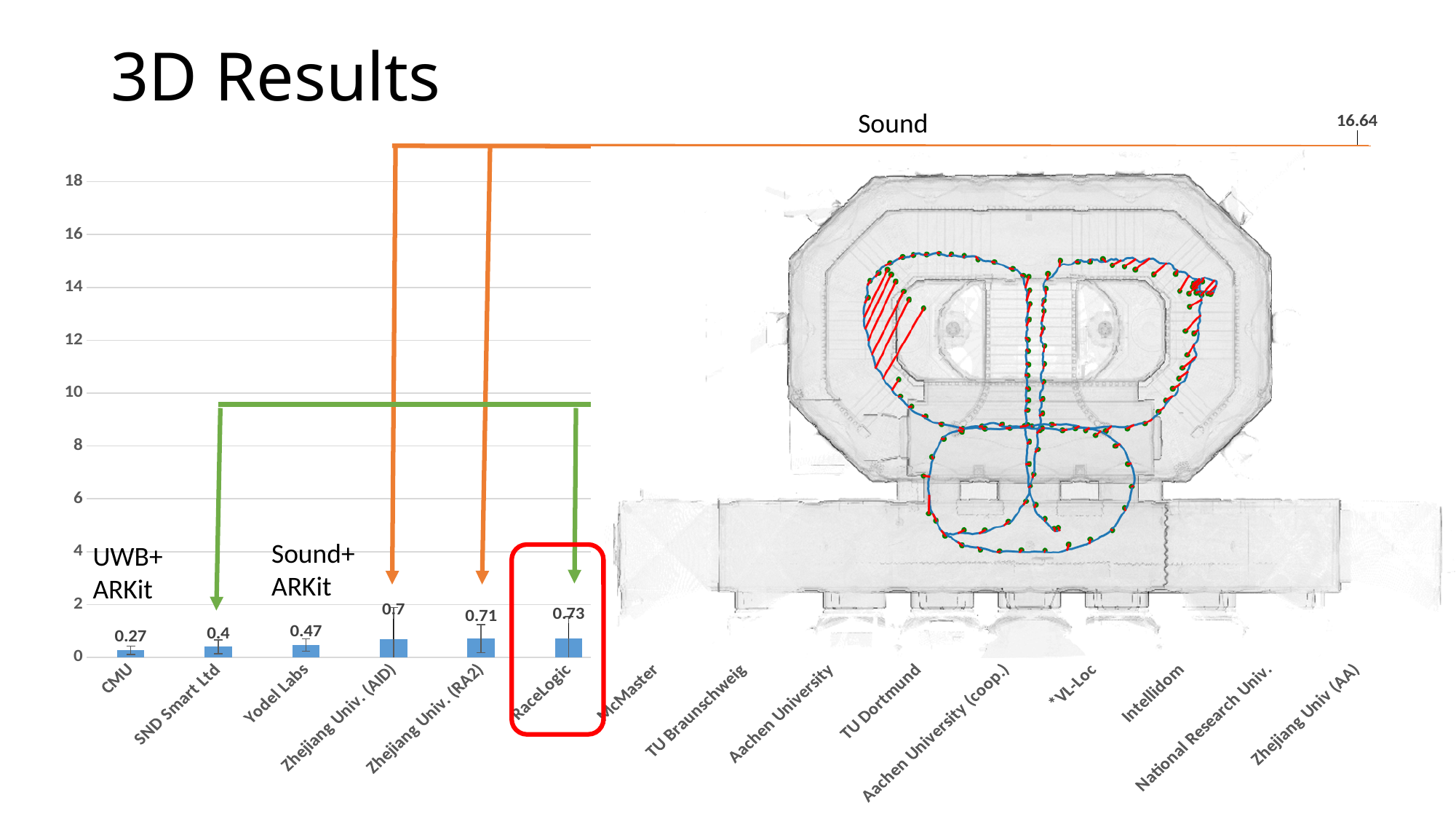
Which category on the chart is highlighted with a red box? RaceLogic What is the value for RaceLogic? 0.73 Among the six bars with printed data labels, which category has the highest value? RaceLogic What is the value for Zhejiang Univ. (AID)? 0.7 Is the value for Zhejiang Univ. (RA2) greater or less than 2? less What is the value for Yodel Labs? 0.47 What is the value for CMU? 0.27 Which is larger, the value for SND Smart Ltd or the value for Yodel Labs? Yodel Labs How many categories are labelled on the x axis of the chart? 15 What is the difference between the values for RaceLogic and CMU? 0.46 Among the six bars with printed data labels, which category has the lowest value? CMU What kind of chart is shown on the slide? bar chart